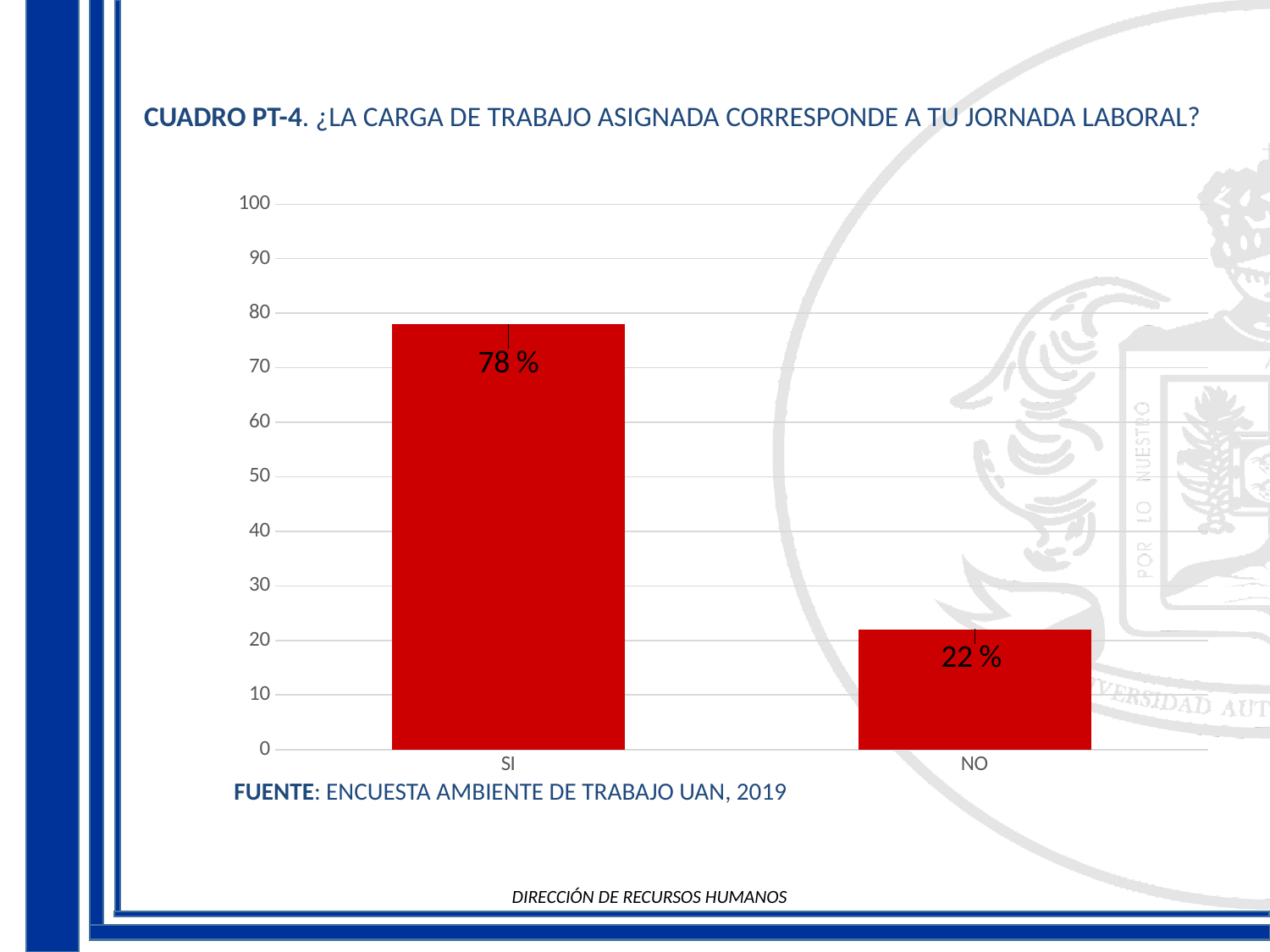
Is the value for SI greater or less than 70? greater How many categories are shown on the x axis? 2 Which category has the lowest value? NO What is the value for SI? 78 % What is the value for NO? 22 % What is the difference between the values for SI and NO? 56 % Which category has the highest value? SI Is the value for NO greater or less than 30? less Which is larger, the value for SI or the value for NO? SI What is the highest value shown on the y axis? 100 What kind of chart is shown on the slide? bar chart What colour are the bars in the chart? red